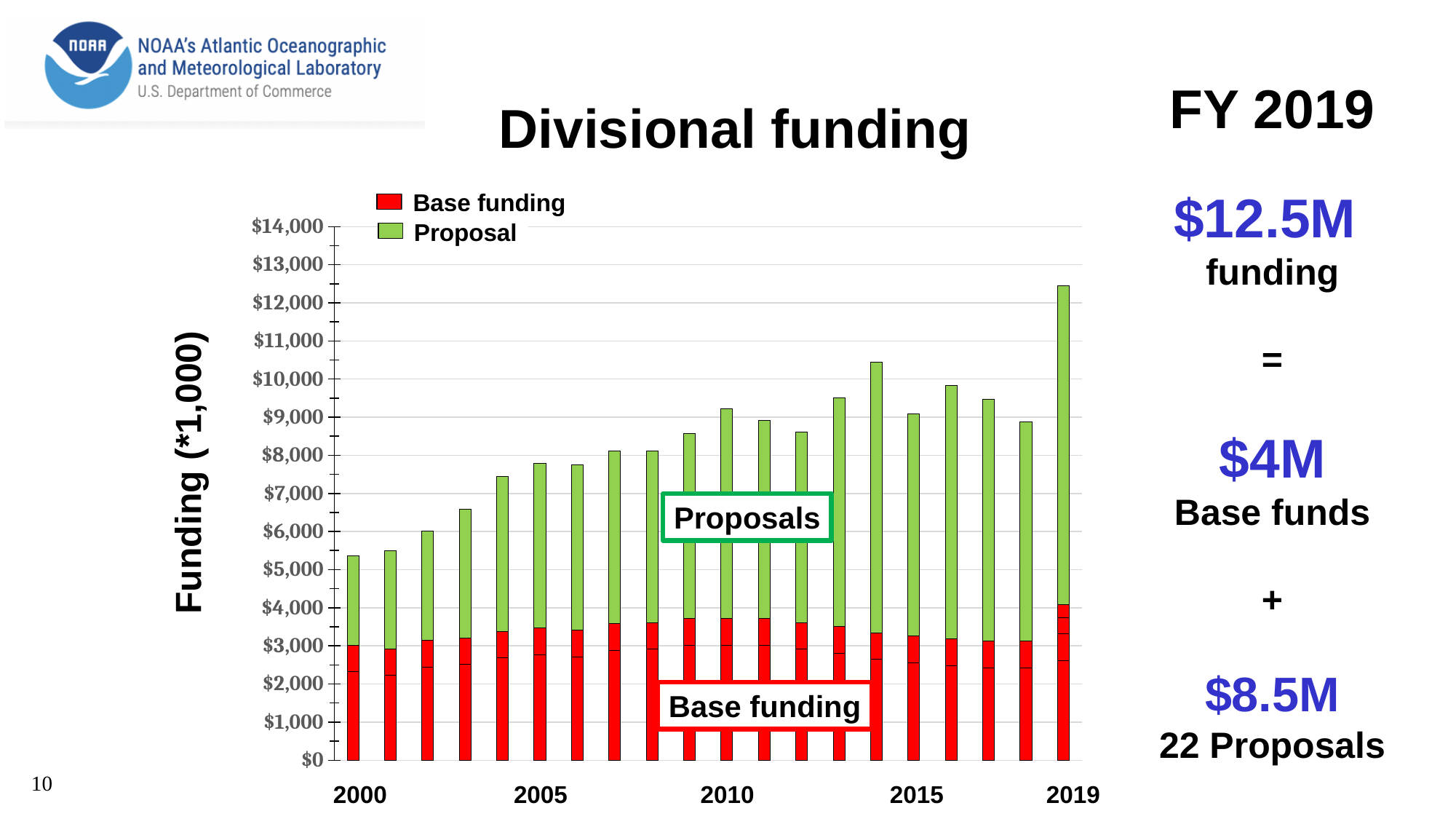
Is the total funding for 2019 greater or less than $12,000? greater What are the two series named in the legend? Base funding and Proposal Which year has the lowest total funding? 2000 Is the total funding for 2014 greater or less than $10,000? greater Does total funding generally rise or fall from 2000 to 2019? rise What kind of chart is shown on the slide? Stacked bar chart How many series does the legend list? 2 What is the title of the chart? Divisional funding Is the total funding for 2000 greater or less than $6,000? less Which year has the highest total funding? 2019 Which year has the larger total funding, 2013 or 2014? 2014 How many years (bars) are plotted in the chart? 20